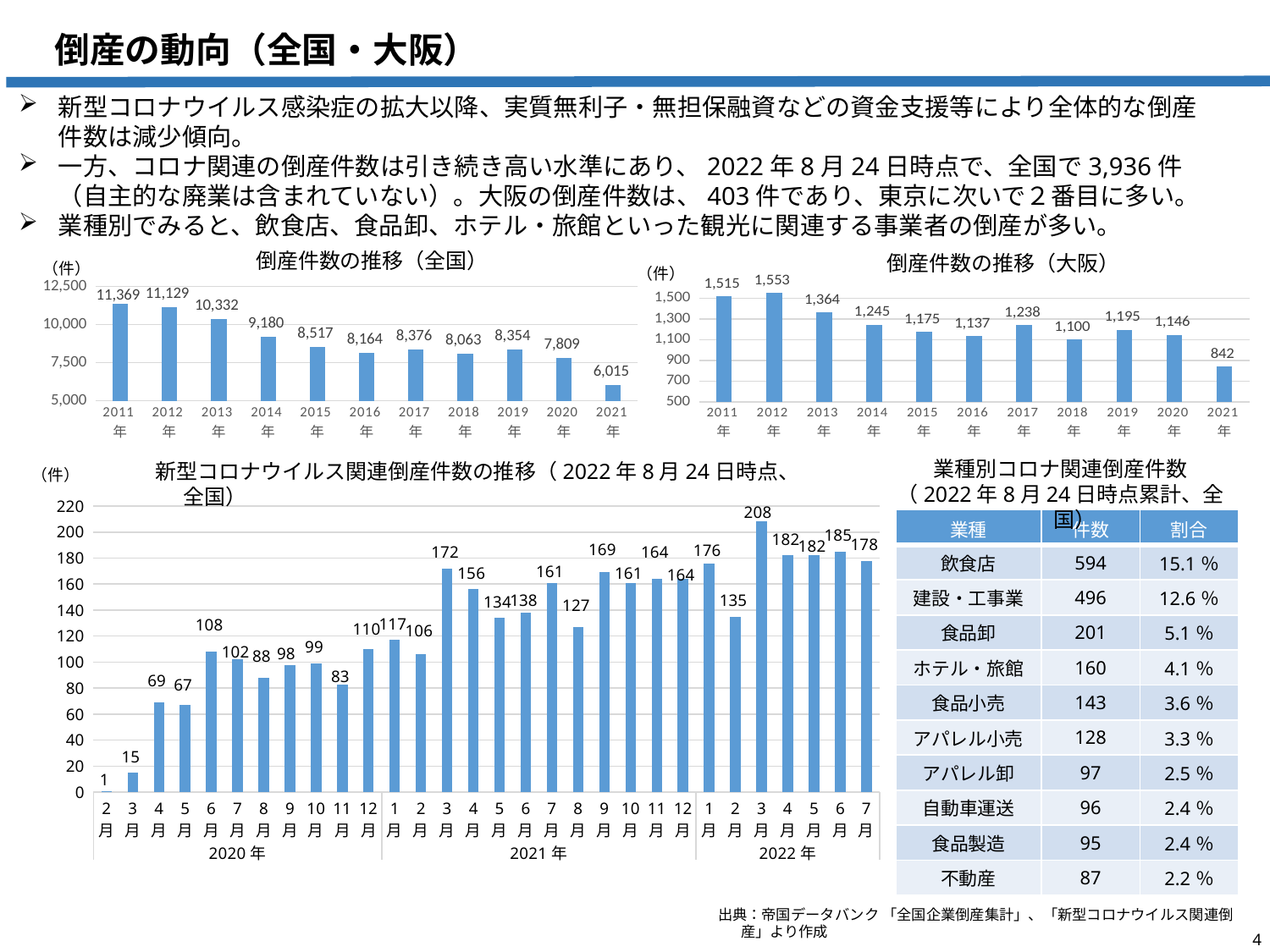
「倒産件数の推移（全国）」のグラフで、2021年の倒産件数はいくつですか？ 6,015 「新型コロナウイルス関連倒産件数の推移」のグラフで、2022年3月の件数はいくつですか？ 208 「新型コロナウイルス関連倒産件数の推移」のグラフで、2021年3月と2021年2月の件数の差はいくつですか？ 66 「倒産件数の推移（全国）」のグラフで、倒産件数が最も多い年はどれですか？ 2011年 「倒産件数の推移（大阪）」のグラフで、2012年の倒産件数はいくつですか？ 1,553 「倒産件数の推移（全国）」のグラフで、2011年と2021年の倒産件数の差はいくつですか？ 5,354 「倒産件数の推移（大阪）」のグラフは、どの種類のグラフですか？ 棒グラフ 「新型コロナウイルス関連倒産件数の推移」のグラフで、2020年2月から2020年6月にかけて件数は増加していますか、減少していますか？ 増加 「新型コロナウイルス関連倒産件数の推移」のグラフで、件数が最も少ない月はどれですか？ 2020年2月 「倒産件数の推移（全国）」のグラフには何本の棒がありますか？ 11 「倒産件数の推移（大阪）」のグラフで、倒産件数が最も少ない年はどれですか？ 2021年 「倒産件数の推移（大阪）」のグラフで、2017年と2018年ではどちらの倒産件数が多いですか？ 2017年